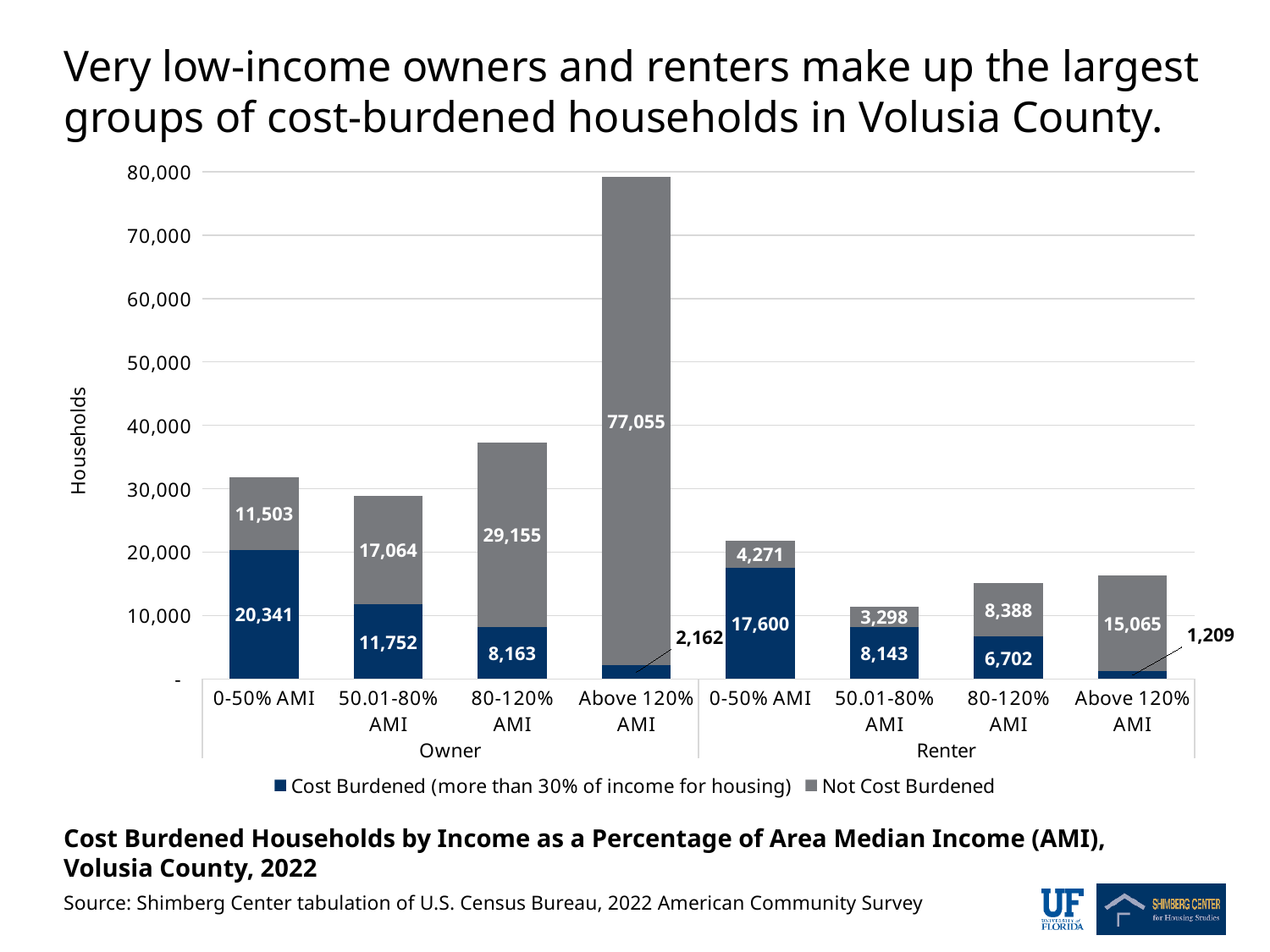
What is the number of cost-burdened renter households with 50.01-80% AMI? 8,143 What is the difference between cost-burdened owner households at 0-50% AMI and cost-burdened renter households at 0-50% AMI? 2,741 How many bars (income categories) are plotted in the chart? 8 What is the total number of renter households with 0-50% AMI (cost burdened plus not cost burdened)? 21,871 Which income category has the lowest number of cost-burdened households? Renter Above 120% AMI How many series does the legend list? 2 What type of chart is shown on the slide? Stacked bar chart What is the number of not cost-burdened owner households with income above 120% AMI? 77,055 Is the total height of the Owner Above 120% AMI bar greater or less than 70,000? greater Which is larger: the number of not cost-burdened renter households at 80-120% AMI or the number of cost-burdened renter households at 80-120% AMI? Not Cost Burdened (8,388) Which income category has the highest number of cost-burdened households? Owner 0-50% AMI What is the number of cost-burdened owner households with 0-50% AMI? 20,341